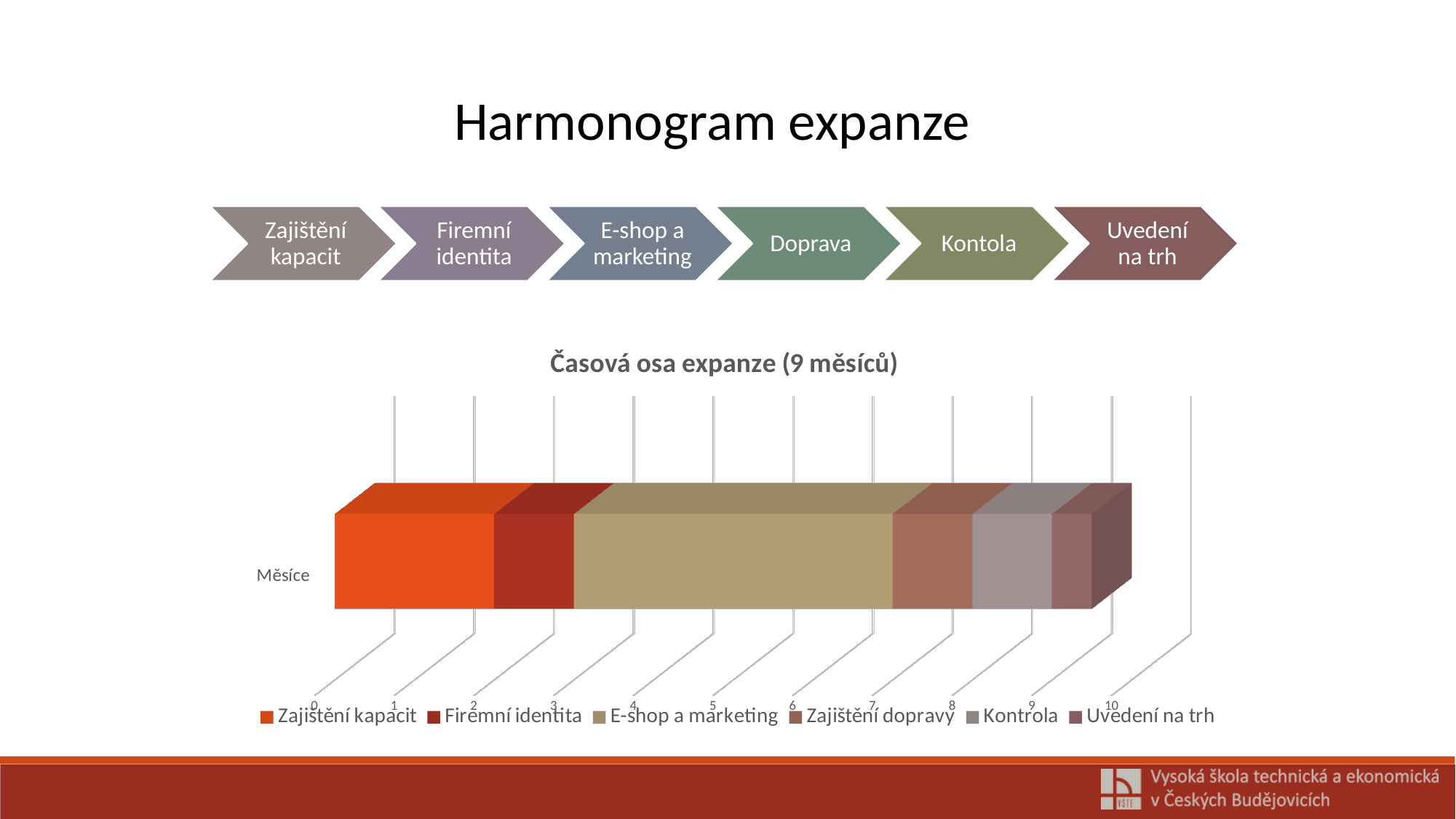
Which segment is longer, Zajištění kapacit or Firemní identita? Zajištění kapacit How many series does the legend of the chart list? 6 Which segment is longer, E-shop a marketing or Kontrola? E-shop a marketing Is the total length of the stacked bar greater or less than 8 on the axis? greater What is the title of the chart? Časová osa expanze (9 měsíců) Which series occupies the largest segment of the bar? E-shop a marketing Which series occupies the smallest segment of the bar? Uvedení na trh Is the segment for E-shop a marketing greater or less than 3 months long? greater How many categories are plotted on the vertical axis of the chart? 1 What is the label of the single category on the chart's vertical axis? Měsíce What is the highest tick value shown on the chart's horizontal axis? 10 What kind of chart is shown under the title "Časová osa expanze (9 měsíců)"? stacked bar chart